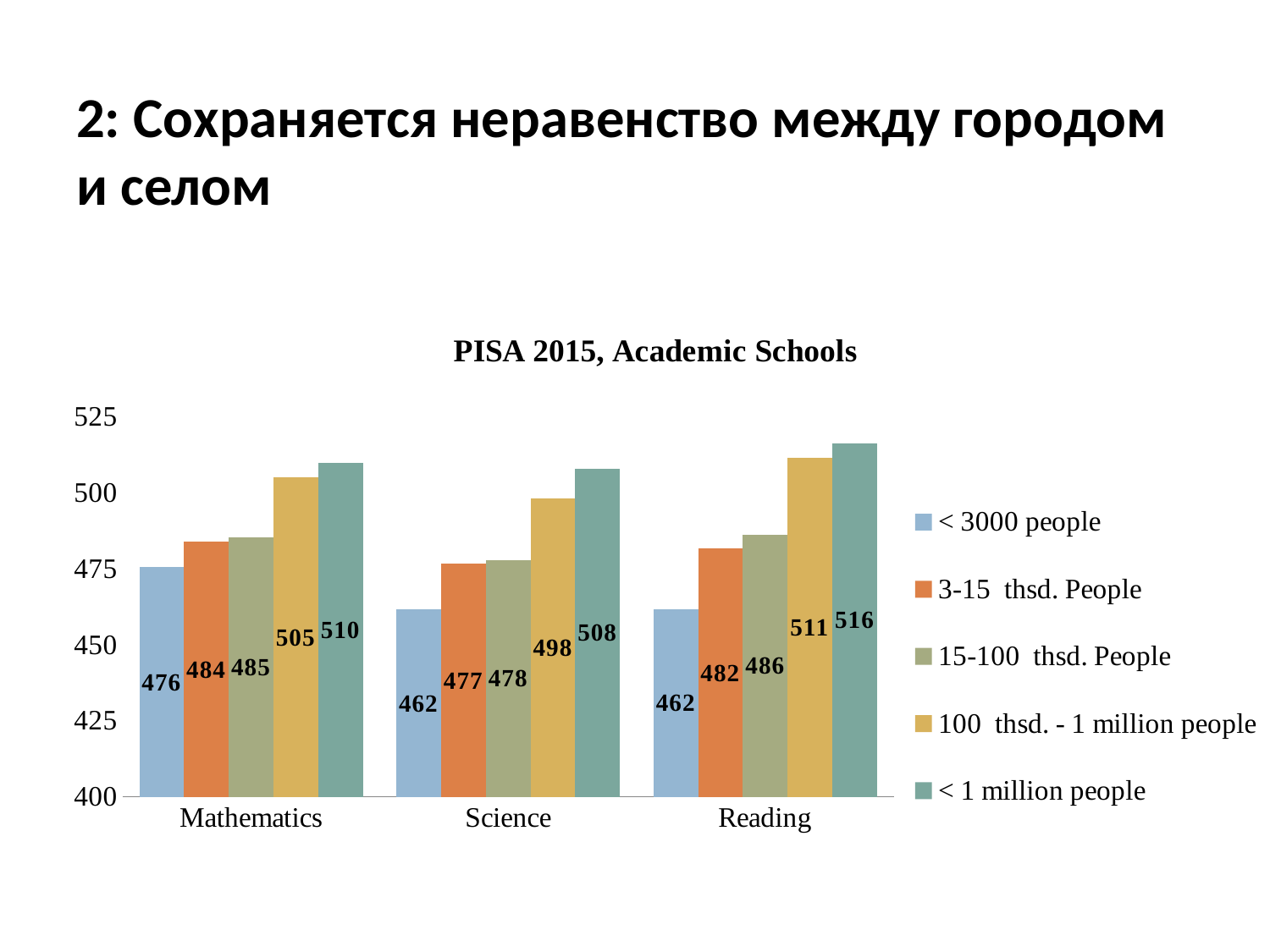
What is the difference between the '100 thsd. - 1 million people' values in Mathematics and Science? 7 What is the value for '< 3000 people' in Mathematics? 476 Which series has the lowest value in Reading? < 3000 people What is the value for '< 1 million people' in Reading? 516 How many categories are shown on the x axis? 3 What is the difference between the '< 1 million people' and '< 3000 people' values in Reading? 54 What is the value for '100 thsd. - 1 million people' in Science? 498 What kind of chart is shown on the slide? Bar chart Which series has the highest value in Science? < 1 million people Which is larger: the '< 3000 people' value in Mathematics or in Science? Mathematics What is the value for '3-15 thsd. People' in Reading? 482 How many series does the legend list? 5